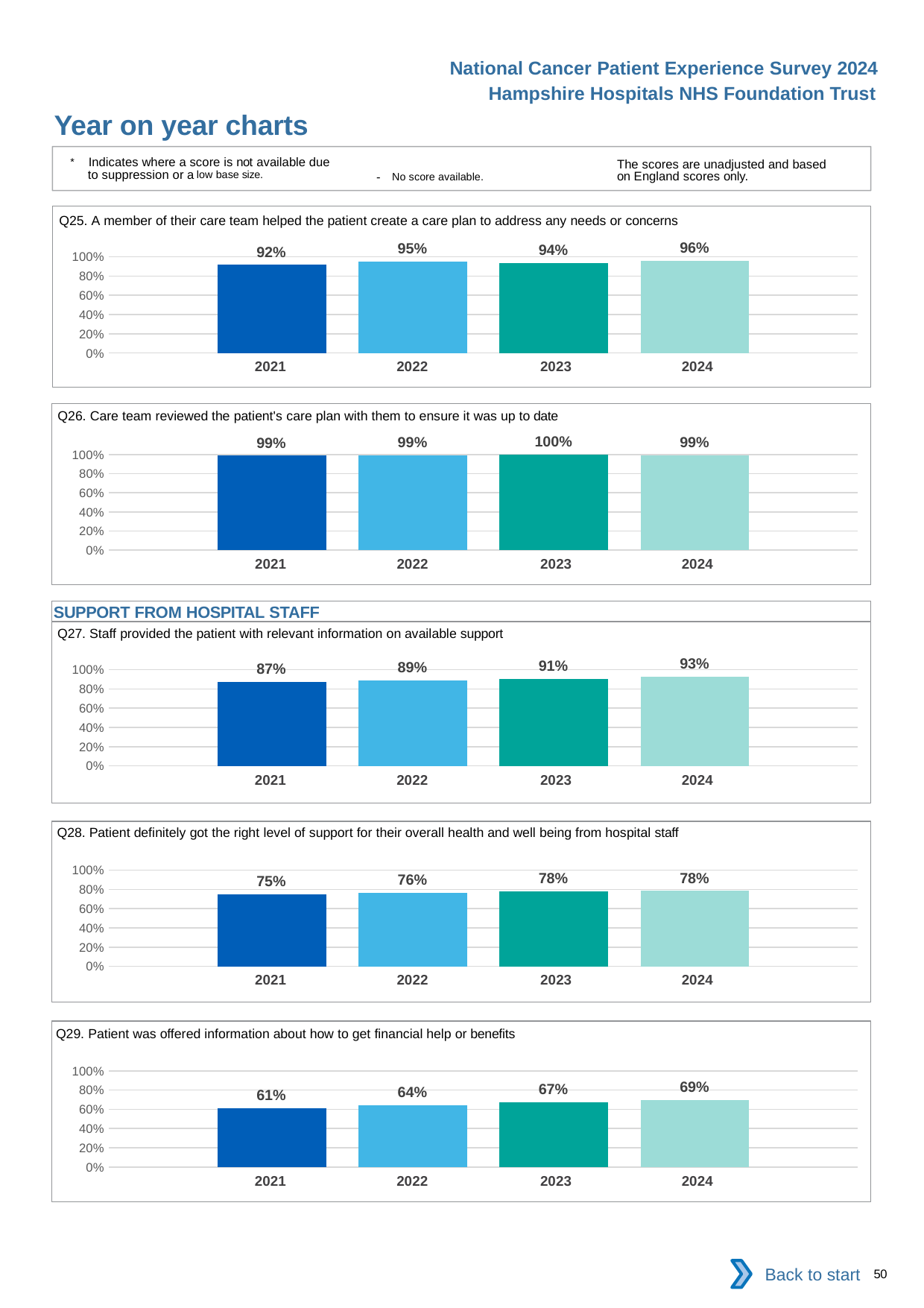
In the Q29 chart, do the values rise or fall from 2021 to 2024? rise In the Q27 chart, what is the value for 2023? 91% In the Q29 chart, is the value for 2021 greater or less than 80%? less In the Q28 chart, what is the value for 2022? 76% In the Q25 chart, which is larger, the value for 2021 or the value for 2022? 2022 In the Q26 chart, which year has the highest value? 2023 In the Q27 chart, what is the difference between the 2024 and 2021 values? 6% How many years are shown in the Q27 chart? 4 In the Q25 chart, what is the value for 2024? 96% What is the section heading shown above the Q27 chart? SUPPORT FROM HOSPITAL STAFF What kind of chart is the Q28 chart? bar chart In the Q29 chart, which year has the lowest value? 2021